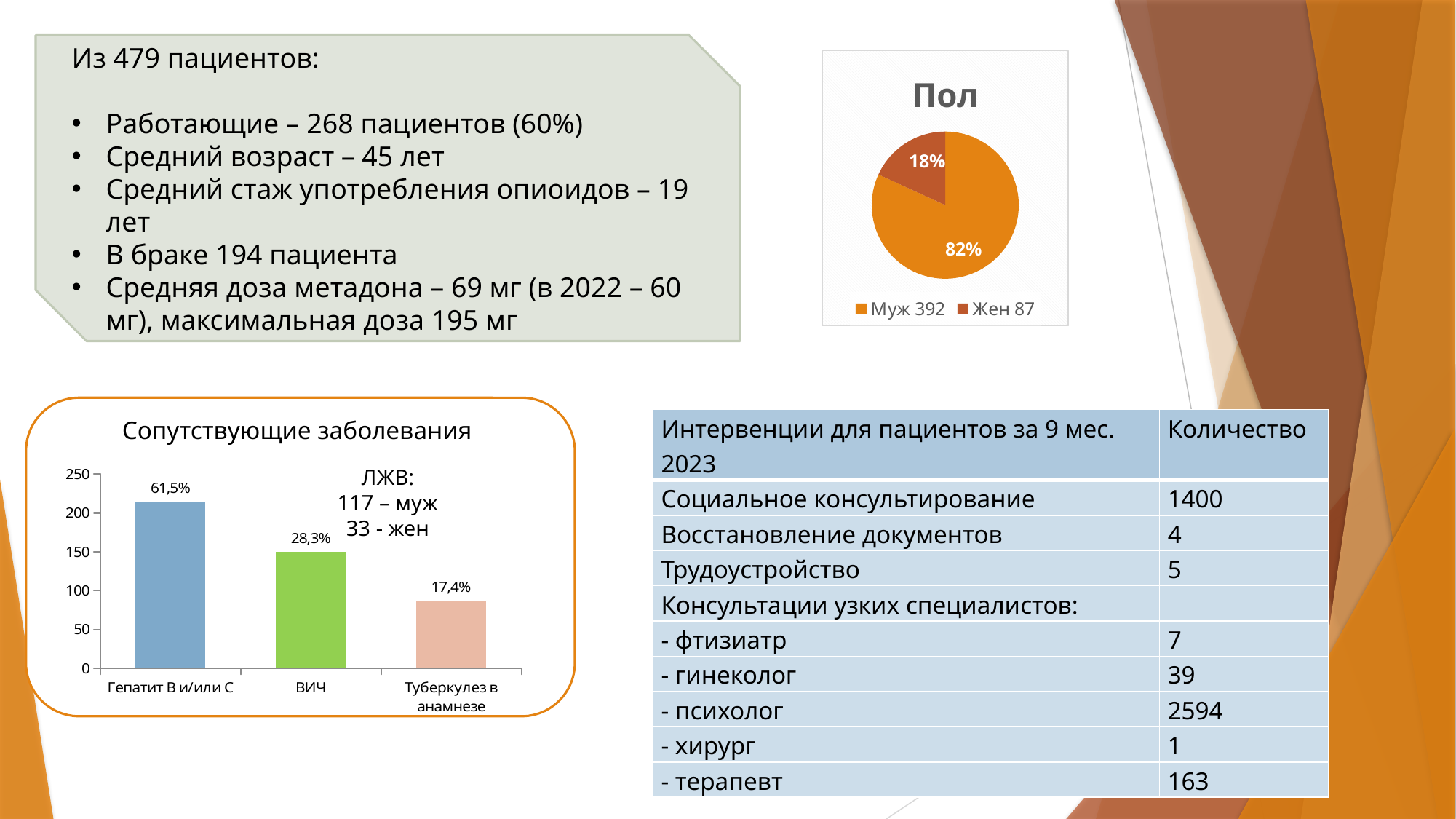
In the "Сопутствующие заболевания" chart, which category has the highest bar? Гепатит B и/или C In the "Пол" pie chart, what count does the legend give for Муж? 392 What kind of chart is the "Пол" chart? pie chart In the "Сопутствующие заболевания" chart, which category has the lowest bar? Туберкулез в анамнезе What kind of chart is the "Сопутствующие заболевания" chart? bar chart In the "Сопутствующие заболевания" chart, what is the data label on the bar for Гепатит B и/или C? 61,5% In the "Сопутствующие заболевания" chart, what is the data label on the bar for ВИЧ? 28,3% In the "Пол" pie chart, what share of the pie is labelled for Муж? 82% In the "Пол" pie chart, how many slices are there? 2 In the "Сопутствующие заболевания" chart, is the bar for Гепатит B и/или C greater or less than 200 on the axis? greater In the "Пол" pie chart, what share of the pie is labelled for Жен? 18% In the "Пол" pie chart, what count does the legend give for Жен? 87